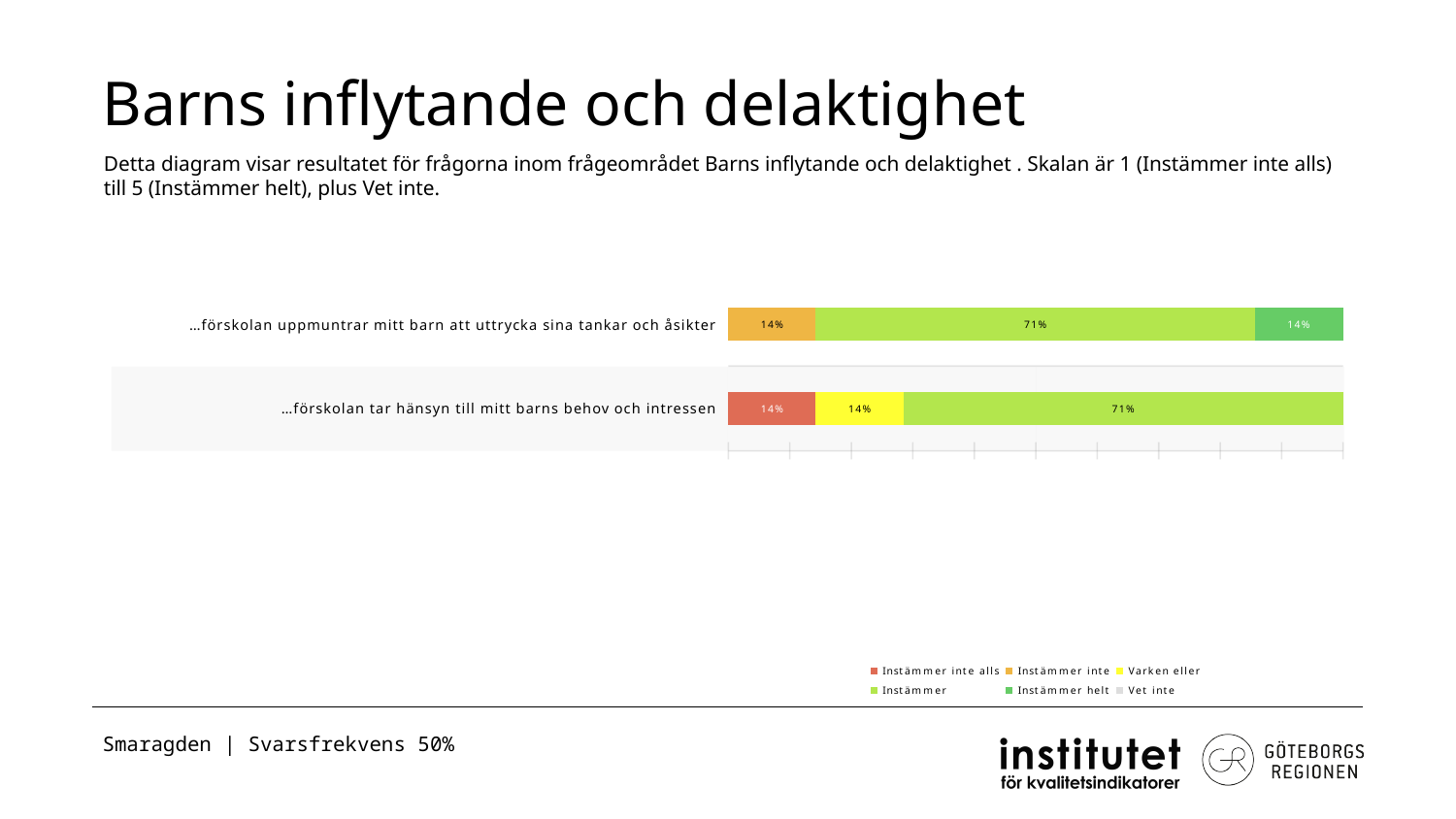
What is the difference between the 'Instämmer' and 'Instämmer helt' segments for '…förskolan uppmuntrar mitt barn att uttrycka sina tankar och åsikter'? 57% What is the total of the labelled segments in the bar for '…förskolan uppmuntrar mitt barn att uttrycka sina tankar och åsikter'? 99% Which is larger for '…förskolan tar hänsyn till mitt barns behov och intressen': the 'Instämmer' segment or the 'Varken eller' segment? Instämmer What is the title of the slide containing the chart? Barns inflytande och delaktighet What is the value of the 'Instämmer helt' segment for '…förskolan uppmuntrar mitt barn att uttrycka sina tankar och åsikter'? 14% What is the value of the 'Varken eller' segment for '…förskolan tar hänsyn till mitt barns behov och intressen'? 14% What is the value of the 'Instämmer inte alls' segment for '…förskolan tar hänsyn till mitt barns behov och intressen'? 14% How many series does the legend list? 6 What is the value of the 'Instämmer' segment for '…förskolan tar hänsyn till mitt barns behov och intressen'? 71% What kind of chart is shown on the slide? Stacked bar chart How many categories (questions) are plotted in the chart? 2 What is the value of the 'Instämmer' segment for '…förskolan uppmuntrar mitt barn att uttrycka sina tankar och åsikter'? 71%